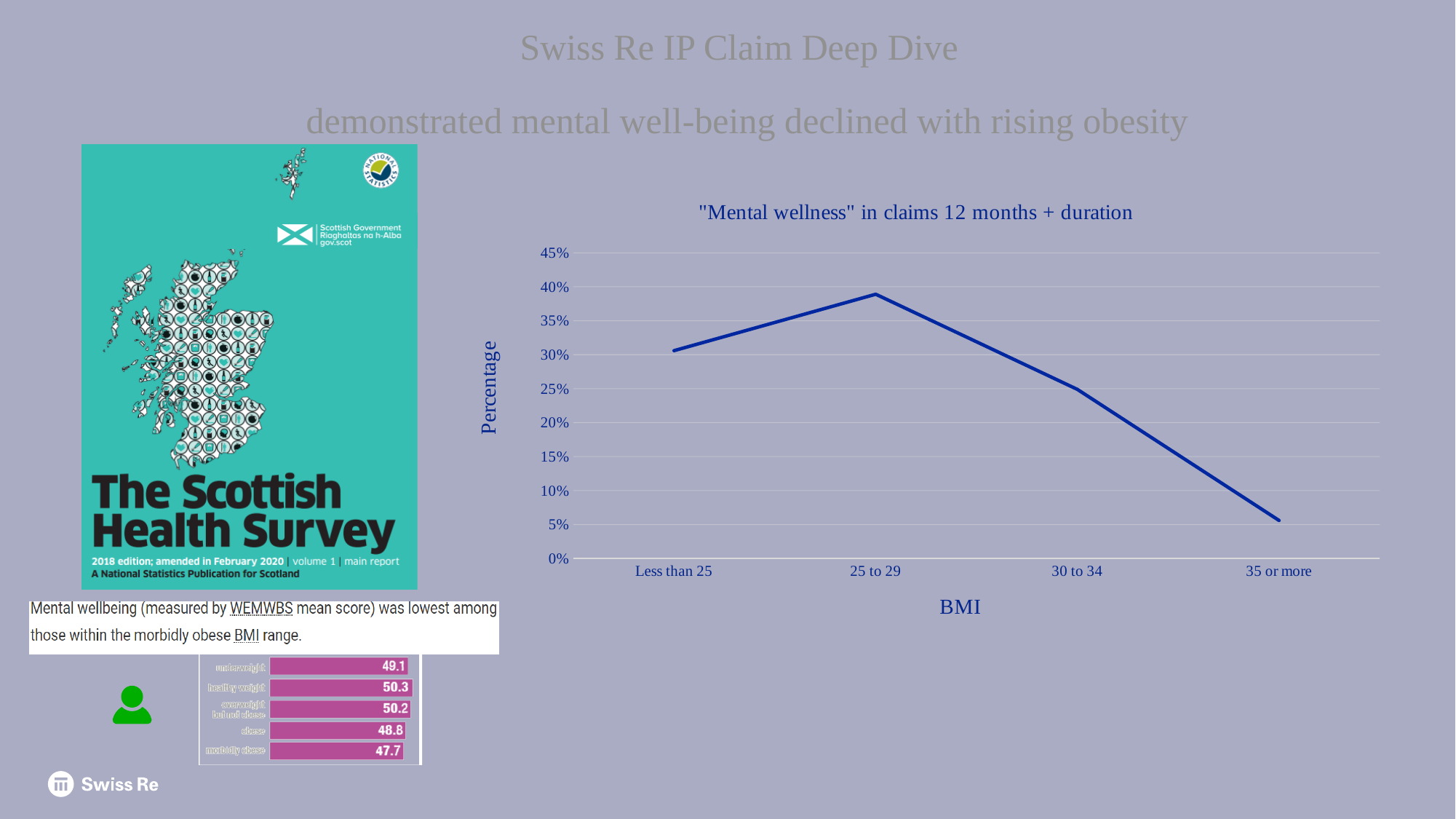
In the "Mental wellness" in claims 12 months + duration chart, how many BMI categories are plotted on the x axis? 4 In the small bar chart at the bottom left of the slide, what is the lowest value shown? 47.7 In the "Mental wellness" in claims 12 months + duration chart, which has the higher percentage: 25 to 29 or 30 to 34? 25 to 29 In the "Mental wellness" in claims 12 months + duration chart, which BMI category has the lowest percentage? 35 or more In the "Mental wellness" in claims 12 months + duration chart, do the values rise or fall from 25 to 29 through 35 or more? fall In the "Mental wellness" in claims 12 months + duration chart, is the value for 35 or more greater or less than 10%? less What kind of chart is "Mental wellness" in claims 12 months + duration? line chart In the "Mental wellness" in claims 12 months + duration chart, is the value for Less than 25 greater or less than 25%? greater In the "Mental wellness" in claims 12 months + duration chart, is the value for 30 to 34 greater or less than 30%? less What is the label on the y axis of the "Mental wellness" in claims 12 months + duration chart? Percentage In the "Mental wellness" in claims 12 months + duration chart, which BMI category has the highest percentage? 25 to 29